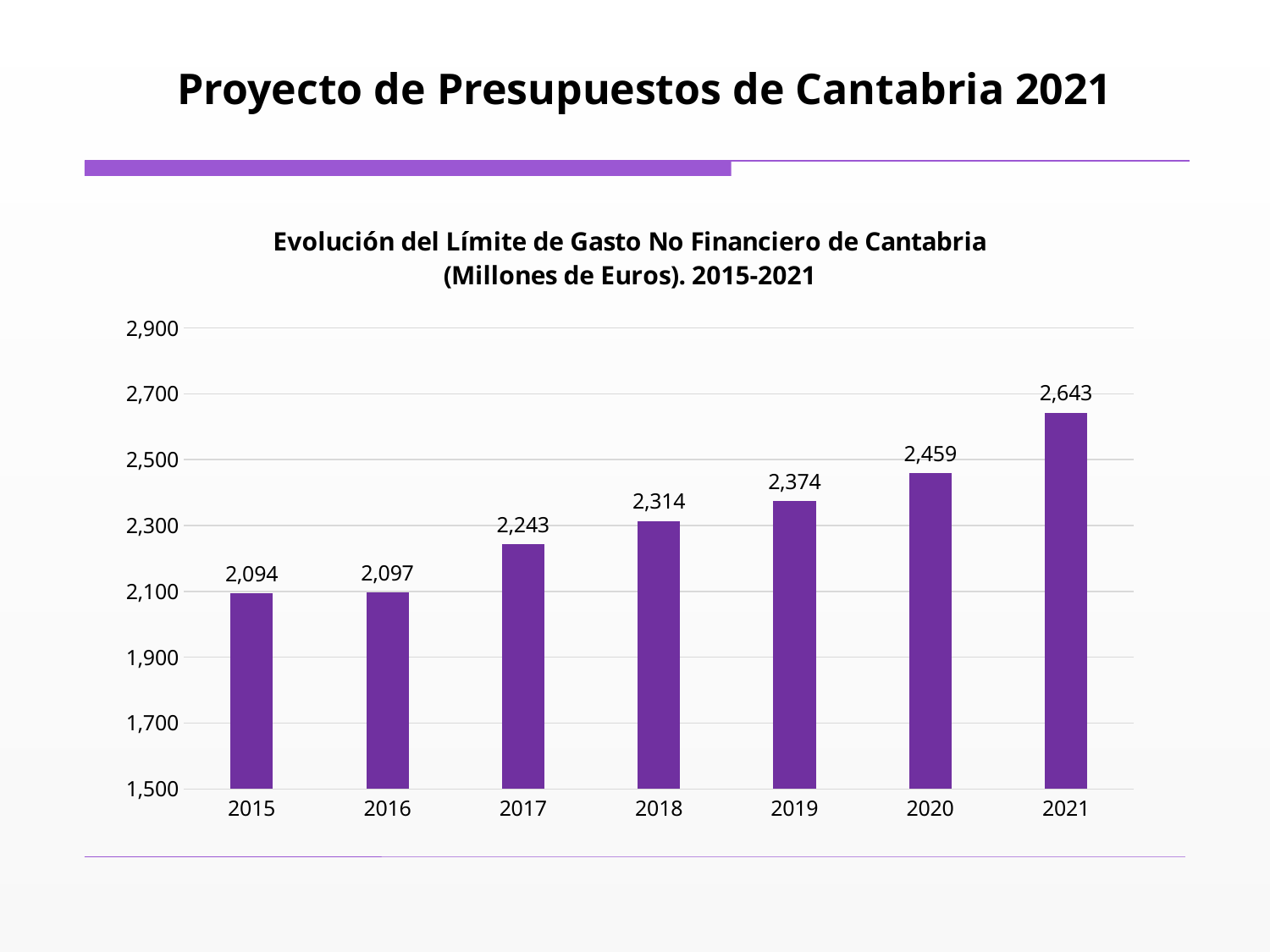
What is the difference between the values for 2017 and 2016? 146 Which is larger, the value for 2019 or the value for 2018? 2019 What is the value for 2021? 2,643 What is the value for 2018? 2,314 Is the value for 2020 greater or less than 2,300? greater What kind of chart is shown on the slide? Bar chart Which year has the lowest value? 2015 Do the values rise or fall from 2015 to 2021? Rise What is the value for 2015? 2,094 What is the difference between the values for 2021 and 2020? 184 How many years are shown on the x axis? 7 Which year has the highest value? 2021